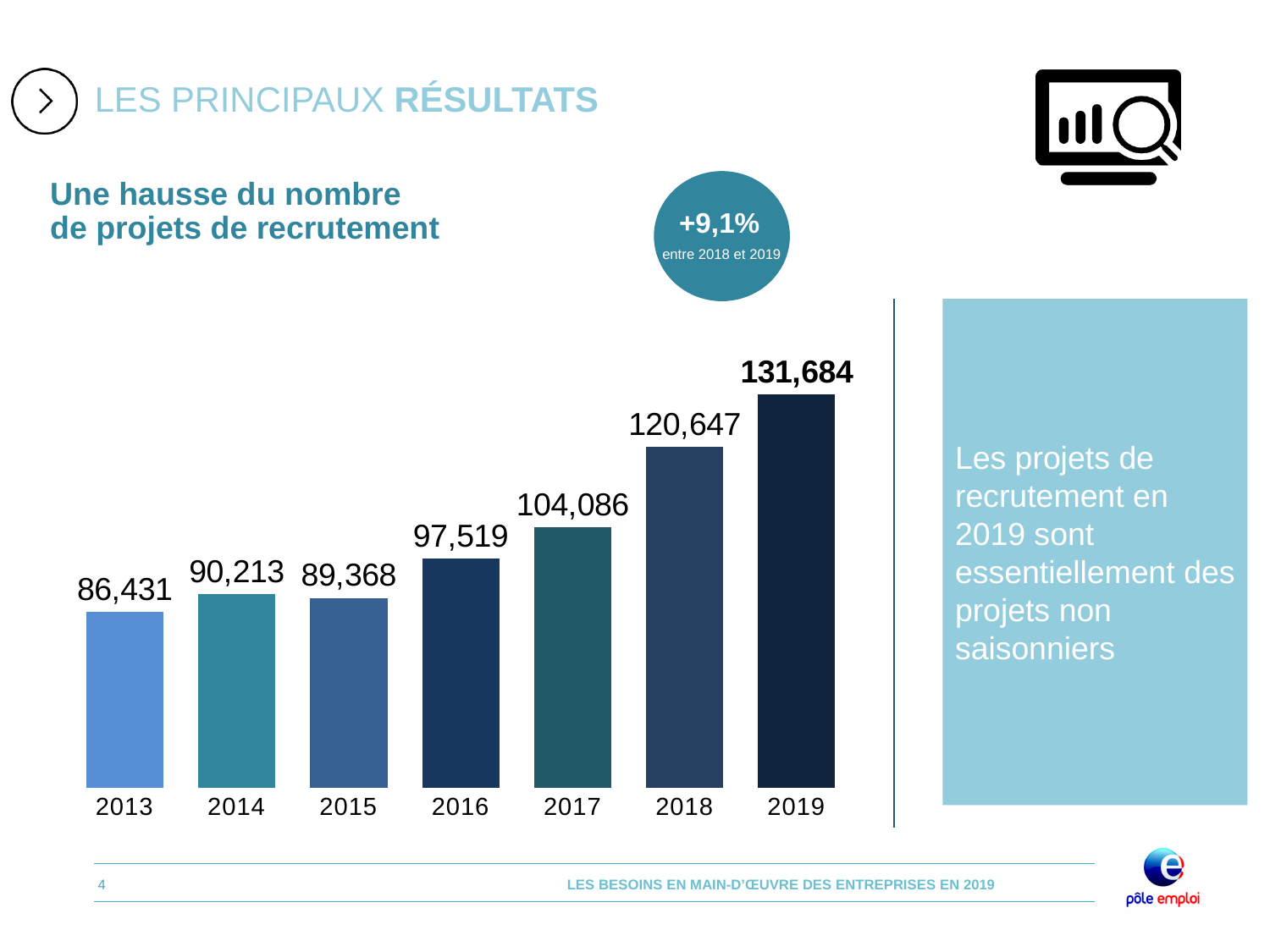
What is the value for 2018? 120,647 What is the value for 2016? 97,519 What kind of chart is shown on the slide? Bar chart What is the value for 2013? 86,431 Which year has the lowest value? 2013 What is the difference between the values for 2019 and 2018? 11,037 What percentage change between 2018 and 2019 is shown in the circle above the chart? +9,1% Which is larger, the value for 2014 or the value for 2015? 2014 What is the difference between the values for 2014 and 2013? 3,782 Which year has the highest value? 2019 How many years are shown on the chart? 7 What is the value for 2019? 131,684